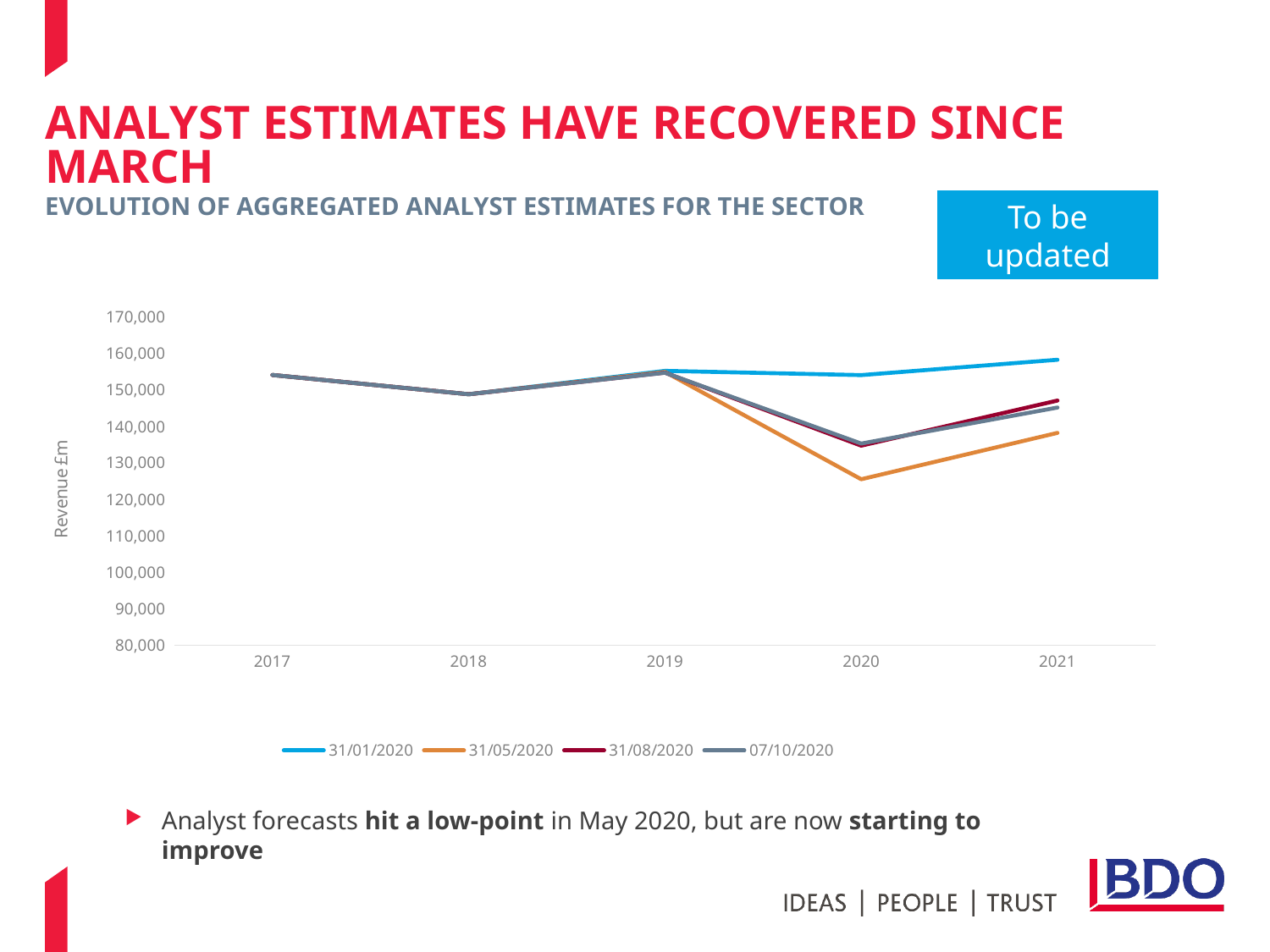
Which series has the lowest value in 2020? 31/05/2020 How many years are shown along the x axis? 5 Is the 2021 value for the 31/05/2020 series greater or less than 130,000? greater In 2020, which is larger: the 31/01/2020 series or the 31/05/2020 series? 31/01/2020 Is the 2020 value for the 31/05/2020 series greater or less than 130,000? less Does the 31/05/2020 series rise or fall from 2019 to 2020? fall What kind of chart is shown on the slide? line chart Is the 2018 value for the 31/01/2020 series greater or less than 140,000? greater How many series does the legend list? 4 What is the label on the y axis? Revenue £m Which series has the highest value in 2021? 31/01/2020